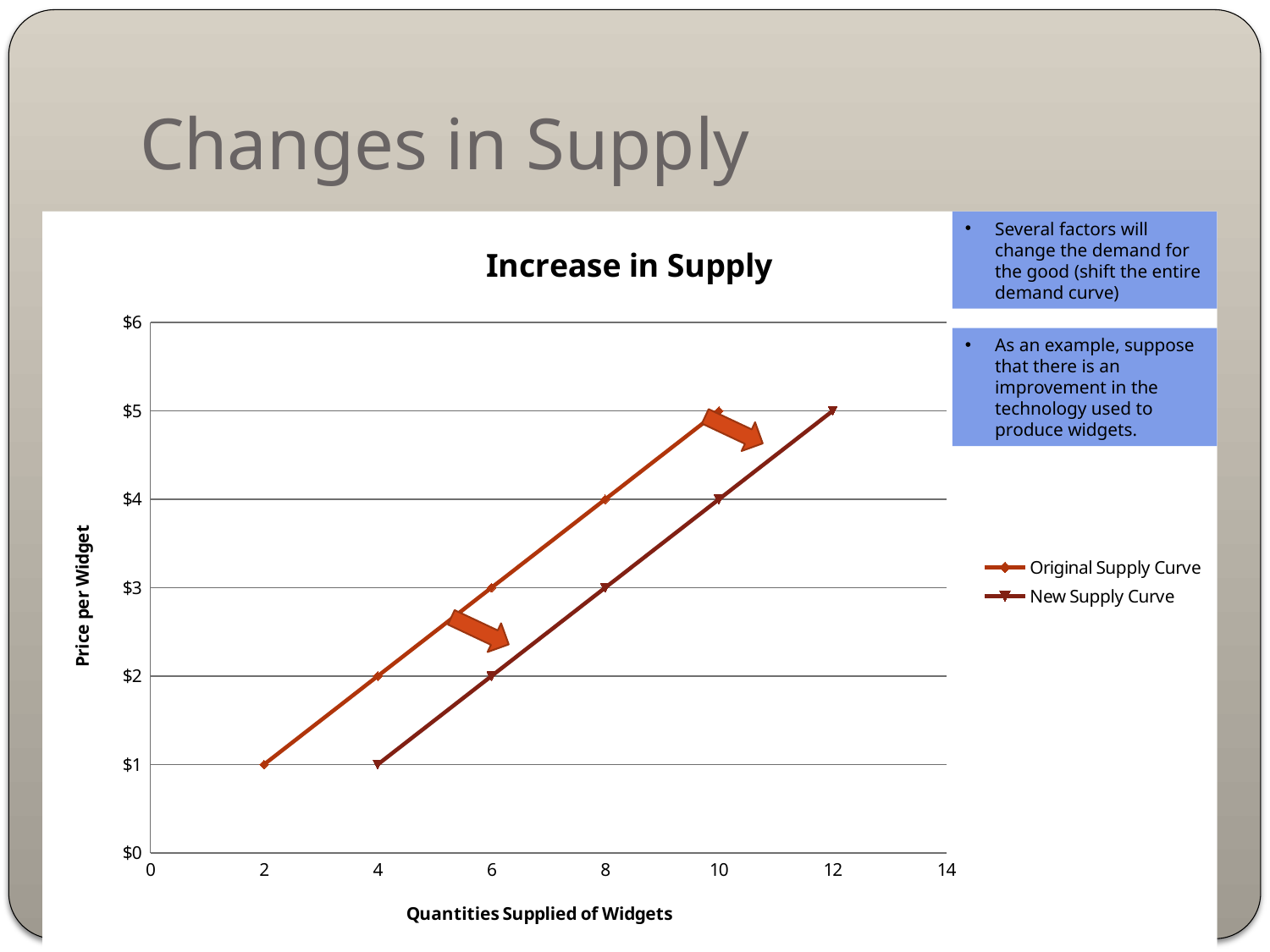
What kind of chart is shown on the slide? line chart At a price of $3, what quantity is supplied on the Original Supply Curve? 6 At a price of $2, which series shows the larger quantity supplied, the Original Supply Curve or the New Supply Curve? New Supply Curve What is the price per widget on the Original Supply Curve when the quantity supplied is 2? $1 How many series does the legend list? 2 What is the title of the chart? Increase in Supply What are the two series named in the legend? Original Supply Curve and New Supply Curve How many data points are plotted on the Original Supply Curve? 5 What is the price per widget on the New Supply Curve when the quantity supplied is 12? $5 At a price of $4, how much larger is the quantity supplied on the New Supply Curve than on the Original Supply Curve? 2 At a price of $3, what quantity is supplied on the New Supply Curve? 8 Does the price per widget rise or fall as the quantity supplied increases along the x axis? rise